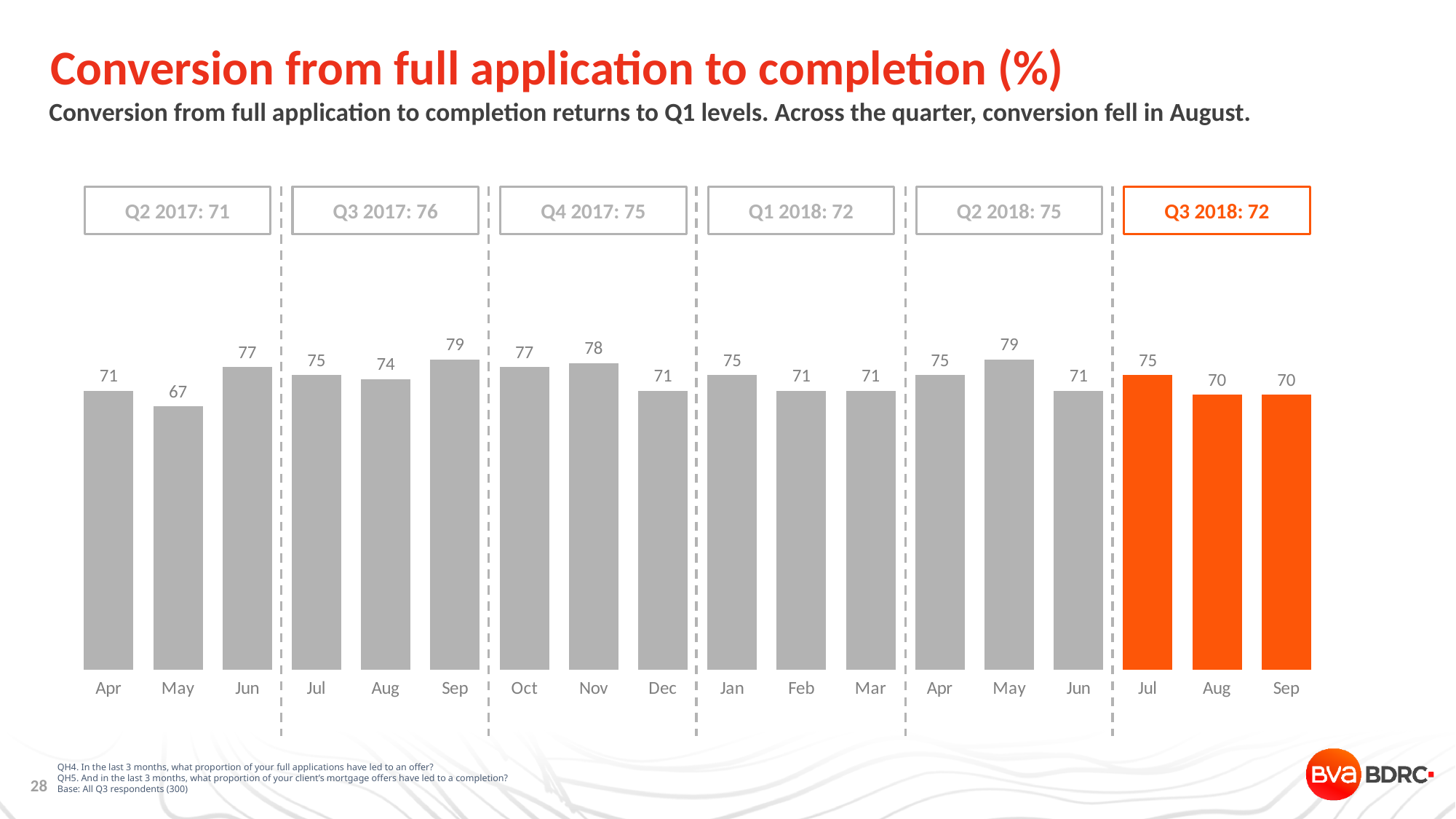
What quarterly value is shown in the box for Q3 2017? 76 Which quarter's bars are highlighted in orange on the chart? Q3 2018 What is the difference between the conversion values for May 2018 and Jun 2018? 8 What is the conversion value for Nov 2017? 78 What type of chart is shown on the slide? Bar chart What is the difference between the conversion values for Jul 2018 and Aug 2018? 5 Which is larger, the conversion value for Sep 2017 or for Sep 2018? Sep 2017 How many monthly bars are plotted on the chart? 18 What is the conversion value for May 2017 (in the Q2 2017 section)? 67 Do the values rise or fall from Jul 2018 to Sep 2018? Fall What is the conversion value for Aug 2018 (in the Q3 2018 section)? 70 Which month has the lowest conversion value on the chart? May 2017